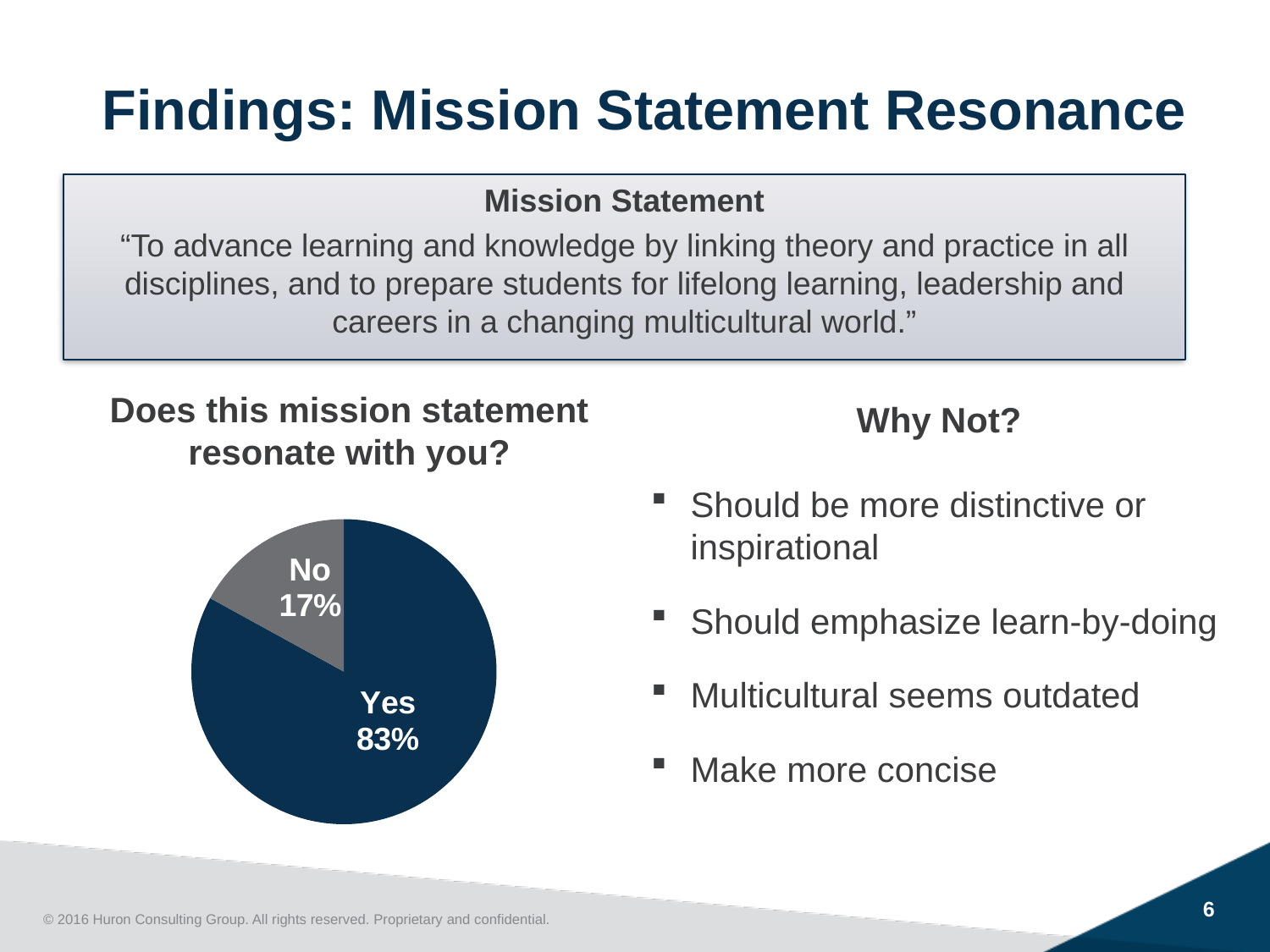
What colour is the Yes slice of the pie chart? dark blue How many slices does the pie chart have? 2 What is the difference in percentage points between the Yes and No responses? 66 What kind of chart is shown on the slide? pie chart Which response has the largest share of the pie? Yes What percentage of respondents answered Yes to whether the mission statement resonates with them? 83% What question does the pie chart answer, according to its title? Does this mission statement resonate with you? Which response has the smallest share of the pie? No Which is larger, the Yes share or the No share? Yes What share of the pie does the No slice represent? 17% What percentage of respondents answered No to whether the mission statement resonates with them? 17%